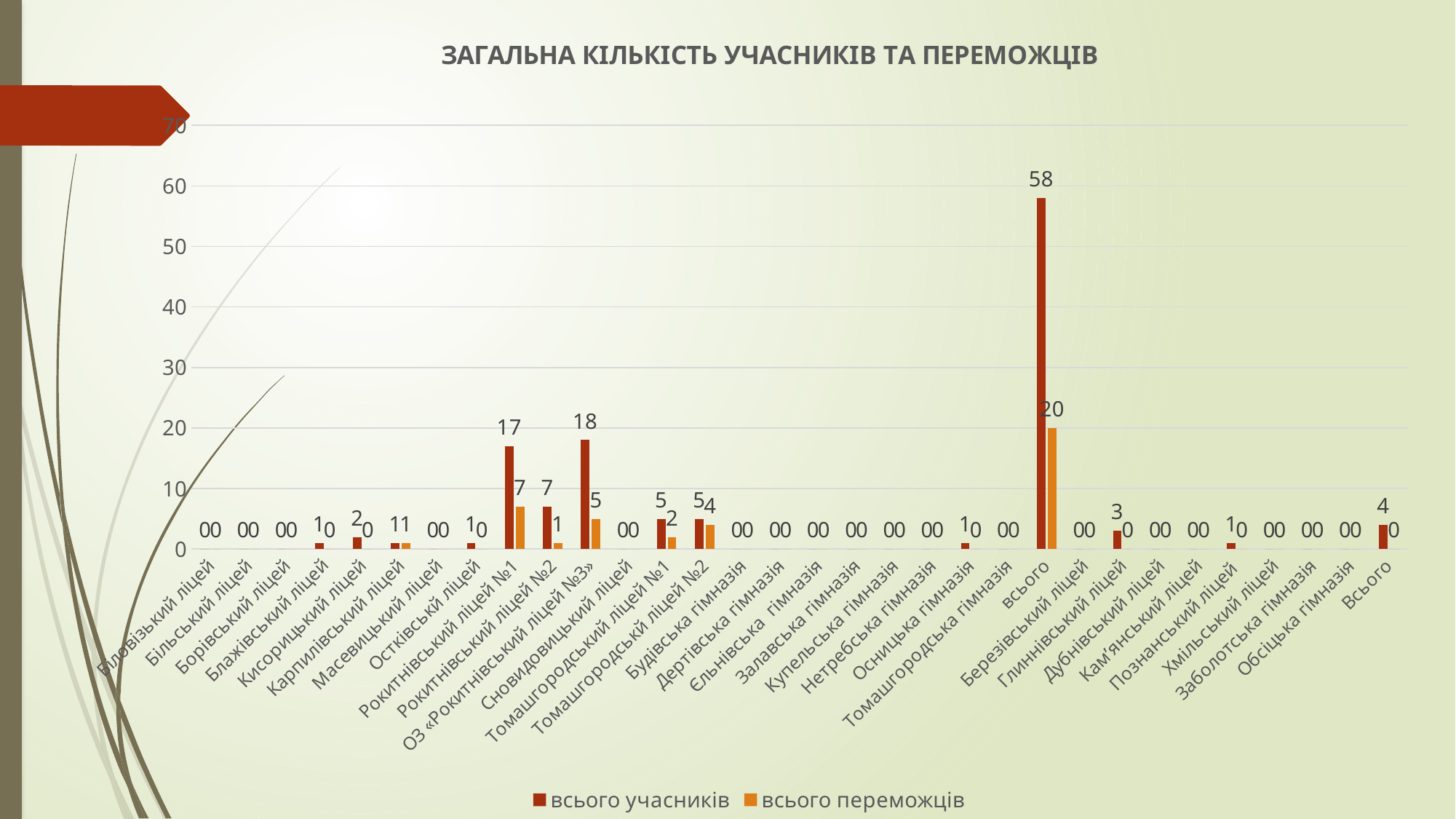
What is the difference between всього учасників for ОЗ «Рокитнівський ліцей №3» and Рокитнівський ліцей №2? 11 What is the value of всього учасників for Рокитнівський ліцей №1? 17 How many series does the legend list? 2 What is the difference between всього учасників and всього переможців for Рокитнівський ліцей №1? 10 Is the value of всього учасників for the category всього greater or less than 50? greater What type of chart is shown on the slide? bar chart Which category has the highest value of всього учасників? всього Which has more всього переможців: Томашгородський ліцей №1 or Томашгородський ліцей №2? Томашгородський ліцей №2 What is the value of всього учасників for Глиннівський ліцей? 3 What is the value of всього переможців for the category всього (after Томашгородська гімназія)? 20 What is the value of всього переможців for ОЗ «Рокитнівський ліцей №3»? 5 Among the individual schools (excluding the totals), which has the highest value of всього учасників? ОЗ «Рокитнівський ліцей №3»